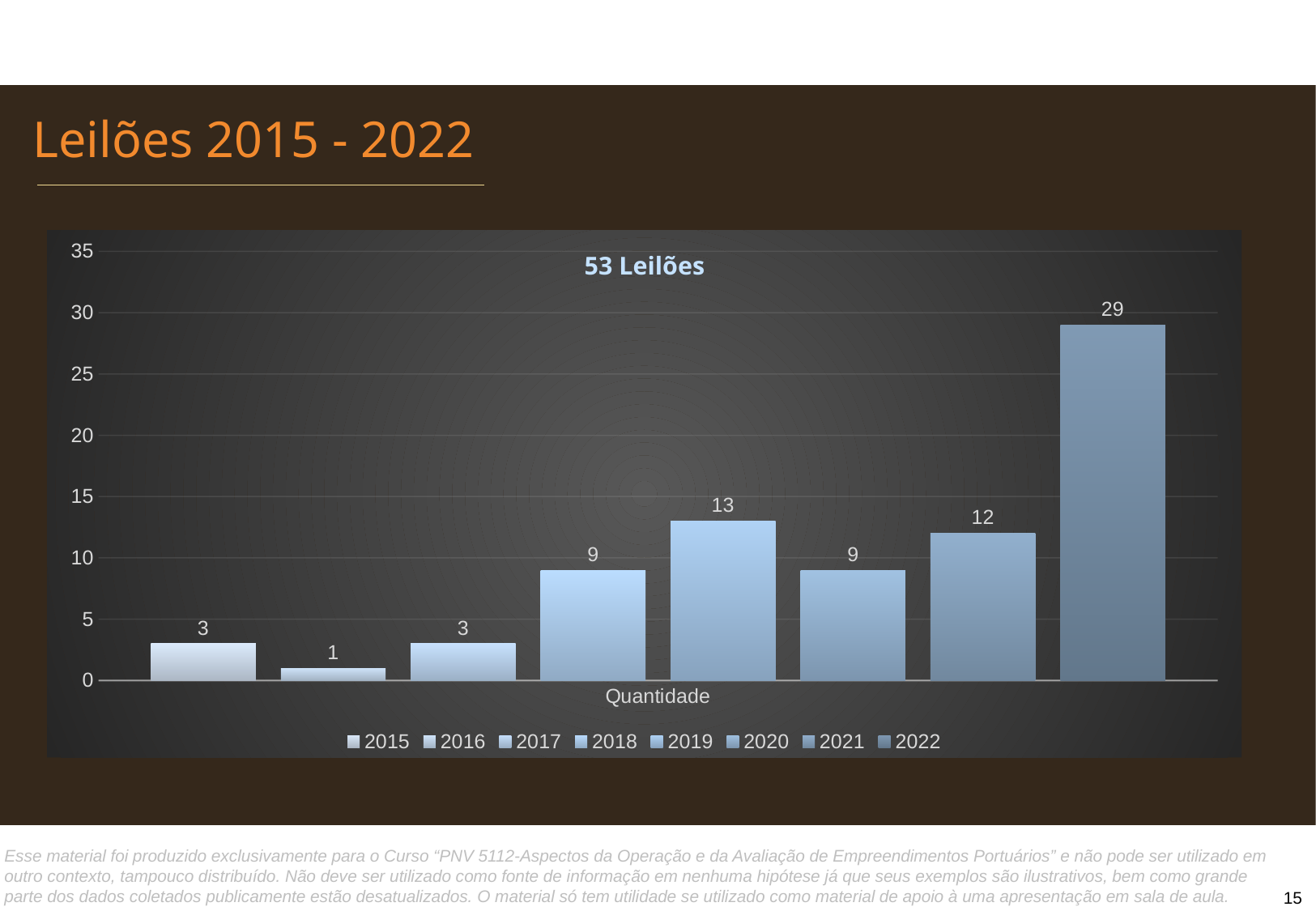
How many series does the legend list? 8 Which year has the highest value? 2022 What kind of chart is shown? bar chart What is the label on the horizontal axis? Quantidade What is the value for 2019? 13 What is the title shown inside the chart area? 53 Leilões Is the value for 2022 greater or less than 25? greater What is the difference between the values for 2022 and 2021? 17 Which is larger, the value for 2019 or the value for 2021? 2019 Which year has the lowest value? 2016 What is the value for 2022? 29 What is the value for 2016? 1